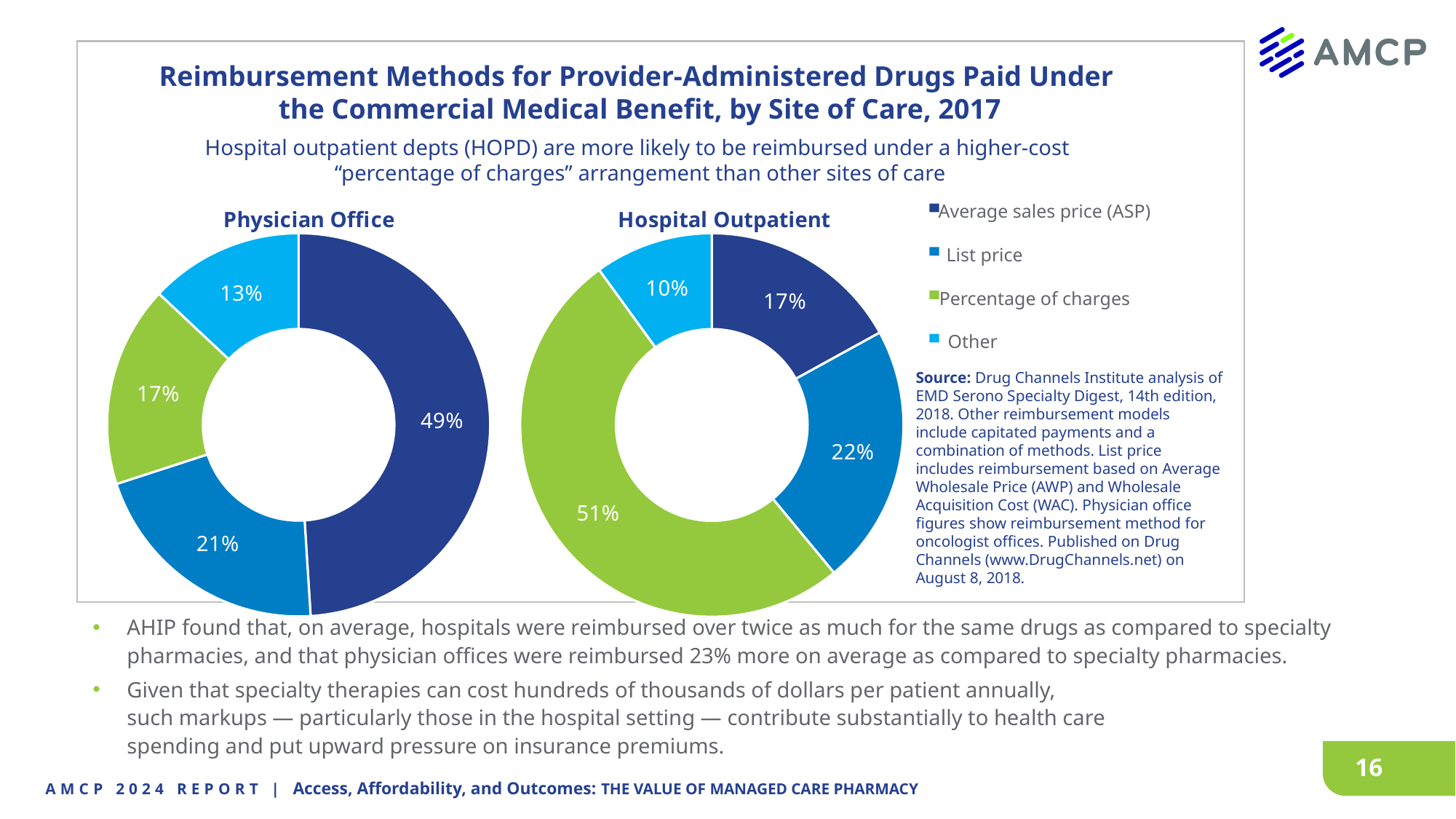
In the Hospital Outpatient chart, what share is reimbursed under Percentage of charges? 51% Which is larger: the List price share in the Physician Office chart or in the Hospital Outpatient chart? Hospital Outpatient How many reimbursement methods does the legend list? 4 In the Physician Office chart, what share is reimbursed under Average sales price (ASP)? 49% In the Hospital Outpatient chart, which reimbursement method has the smallest share? Other What colour represents Percentage of charges in the charts? Green What is the difference between the Percentage of charges share in the Hospital Outpatient chart and in the Physician Office chart? 34 percentage points How many charts are shown on the slide? 2 In the Physician Office chart, what share is reimbursed under Other? 13% In the Physician Office chart, which reimbursement method has the largest share? Average sales price (ASP) What kind of chart is used for the Physician Office data? Doughnut (pie) chart In the Hospital Outpatient chart, what share is reimbursed under List price? 22%